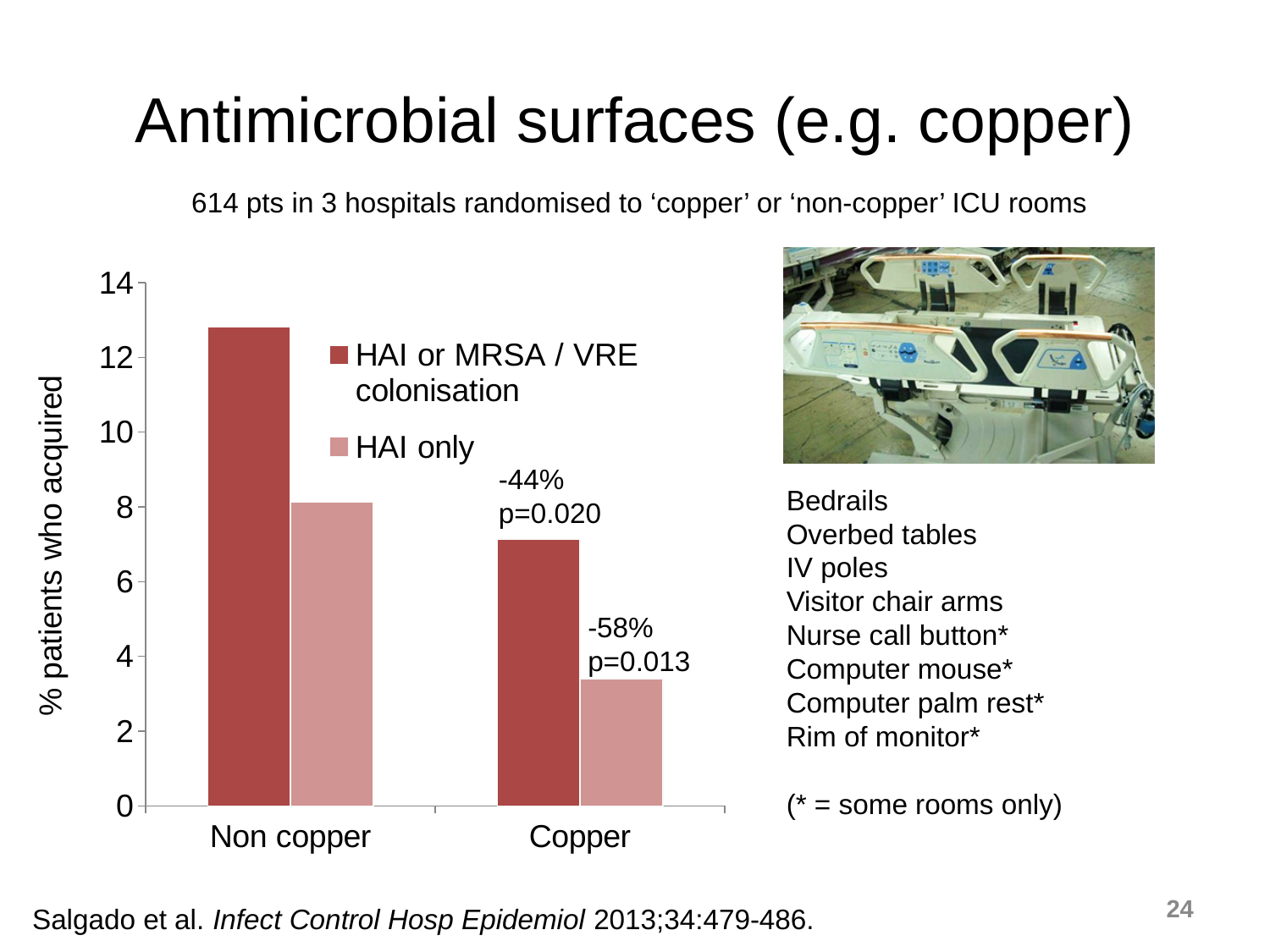
How many categories are shown on the x axis of the chart? 2 Which is larger: the 'HAI only' value for Non copper or the 'HAI or MRSA / VRE colonisation' value for Copper? HAI only for Non copper Is the 'HAI only' value for Copper greater or less than 4? less Which category has the lowest bar for 'HAI only'? Copper Do the values for both series rise or fall from Non copper to Copper? Fall What is the label on the y axis of the chart? % patients who acquired Which category has the highest bar for 'HAI or MRSA / VRE colonisation'? Non copper Is the 'HAI or MRSA / VRE colonisation' value for Copper greater or less than 8? less How many series does the chart legend list? 2 Is the 'HAI or MRSA / VRE colonisation' value for Non copper greater or less than 12? greater What kind of chart is shown on the slide? Bar chart